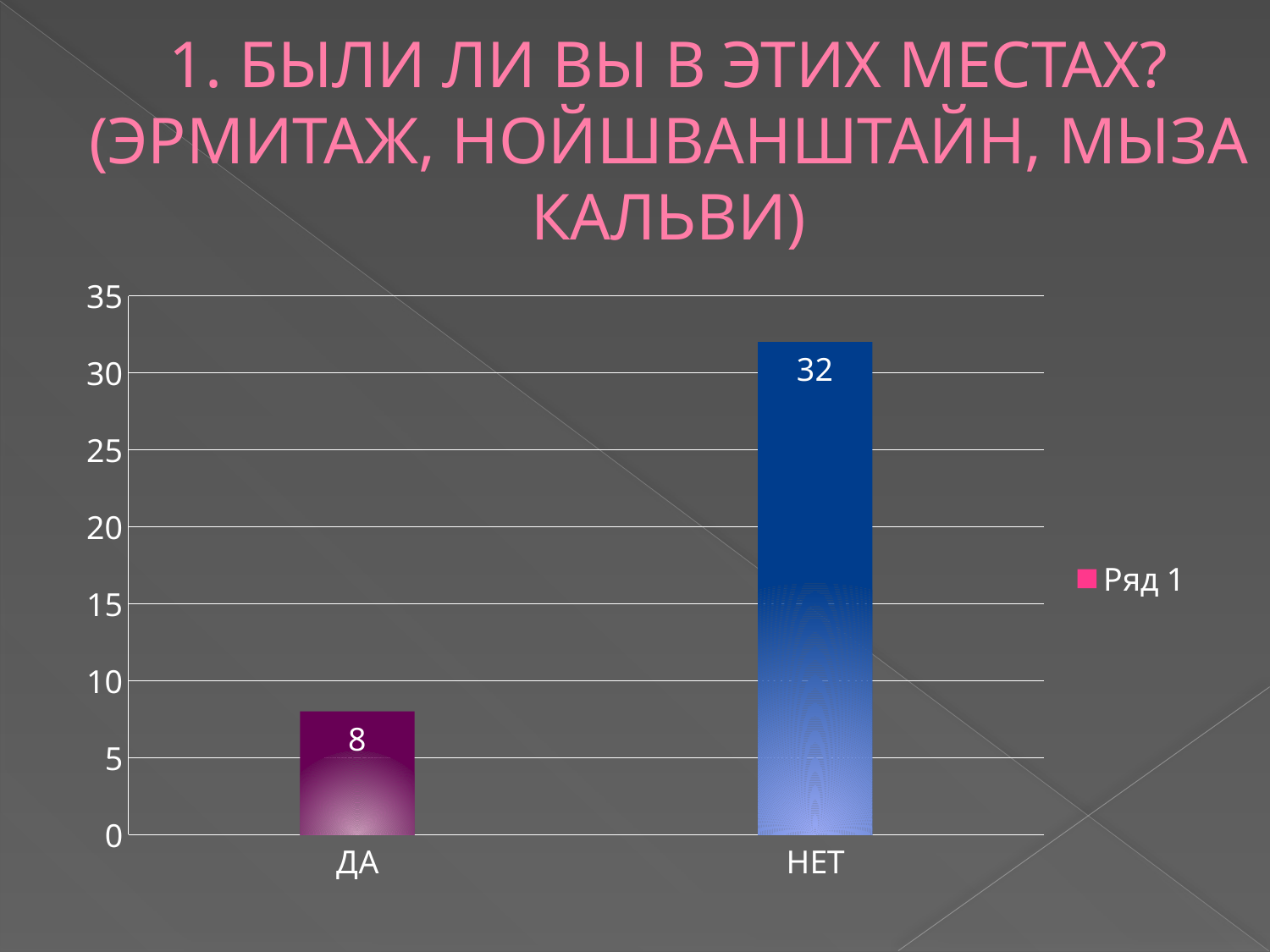
Is the value for ДА greater or less than 10? less Which is larger, the value for ДА or the value for НЕТ? НЕТ Is the value for НЕТ greater or less than 30? greater Which category has the highest value? НЕТ How many series does the legend list? 1 Which category has the lowest value? ДА What is the name of the series listed in the legend? Ряд 1 How many categories are shown on the x axis? 2 What is the value for НЕТ? 32 What kind of chart is shown on the slide? bar chart What is the difference between the values for НЕТ and ДА? 24 What is the value for ДА? 8